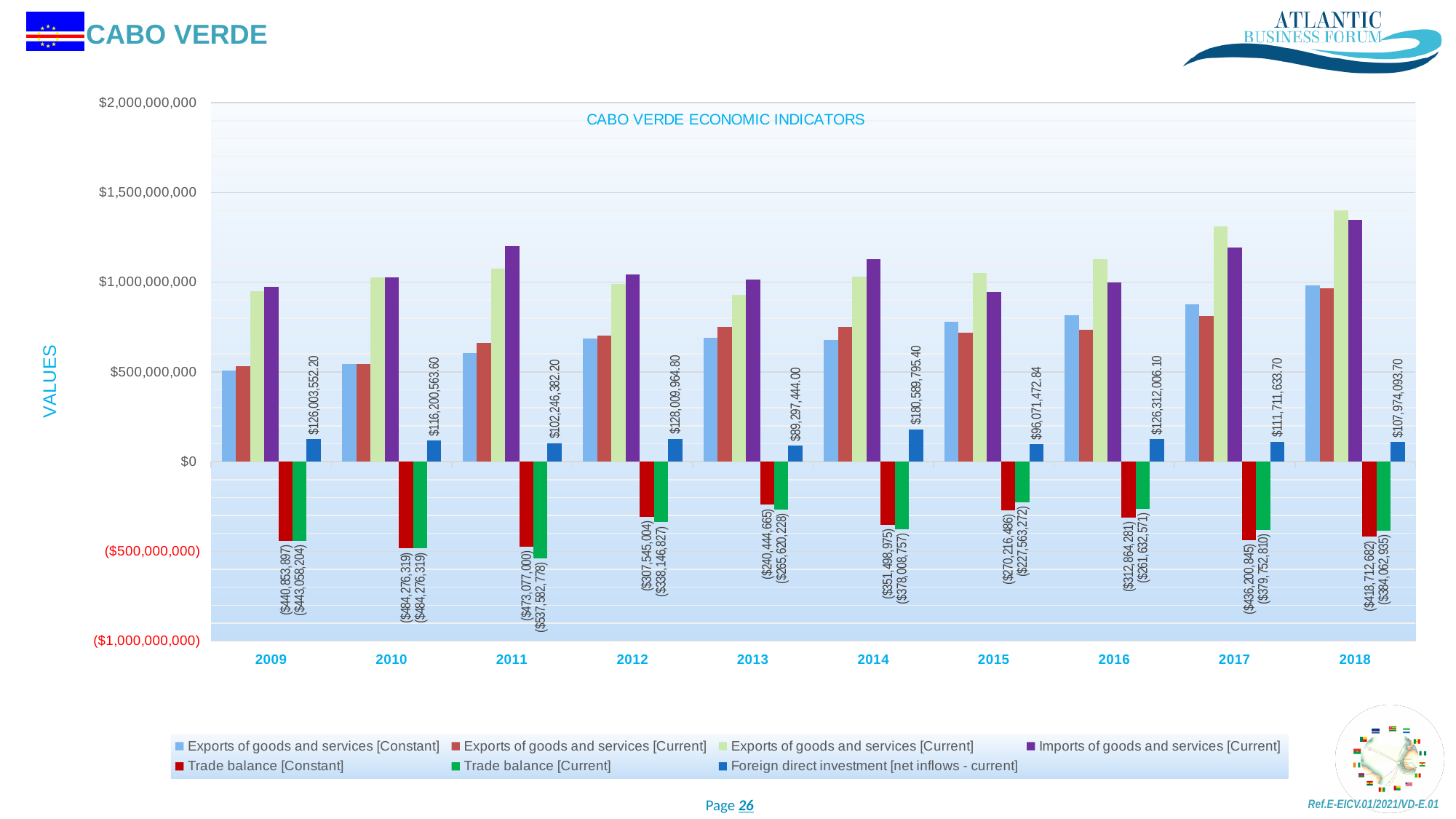
Which year has the larger Foreign direct investment [net inflows - current], 2009 or 2010? 2009 What is the value of Trade balance [Constant] in 2013? ($240,444,665) What kind of chart is shown on the slide? Bar chart How many years are shown on the x axis of the chart? 10 What is the value of Foreign direct investment [net inflows - current] in 2014? $180,589,795.40 In which year is Foreign direct investment [net inflows - current] the highest? 2014 In which year is Foreign direct investment [net inflows - current] the lowest? 2013 What is the difference between Foreign direct investment [net inflows - current] in 2012 and in 2013? $38,712,520.80 What is the value of Trade balance [Current] in 2011? ($537,582,778) Is the value of Imports of goods and services [Current] in 2018 greater or less than $1,000,000,000? greater How many series does the chart's legend list? 7 What is the title of the chart? CABO VERDE ECONOMIC INDICATORS